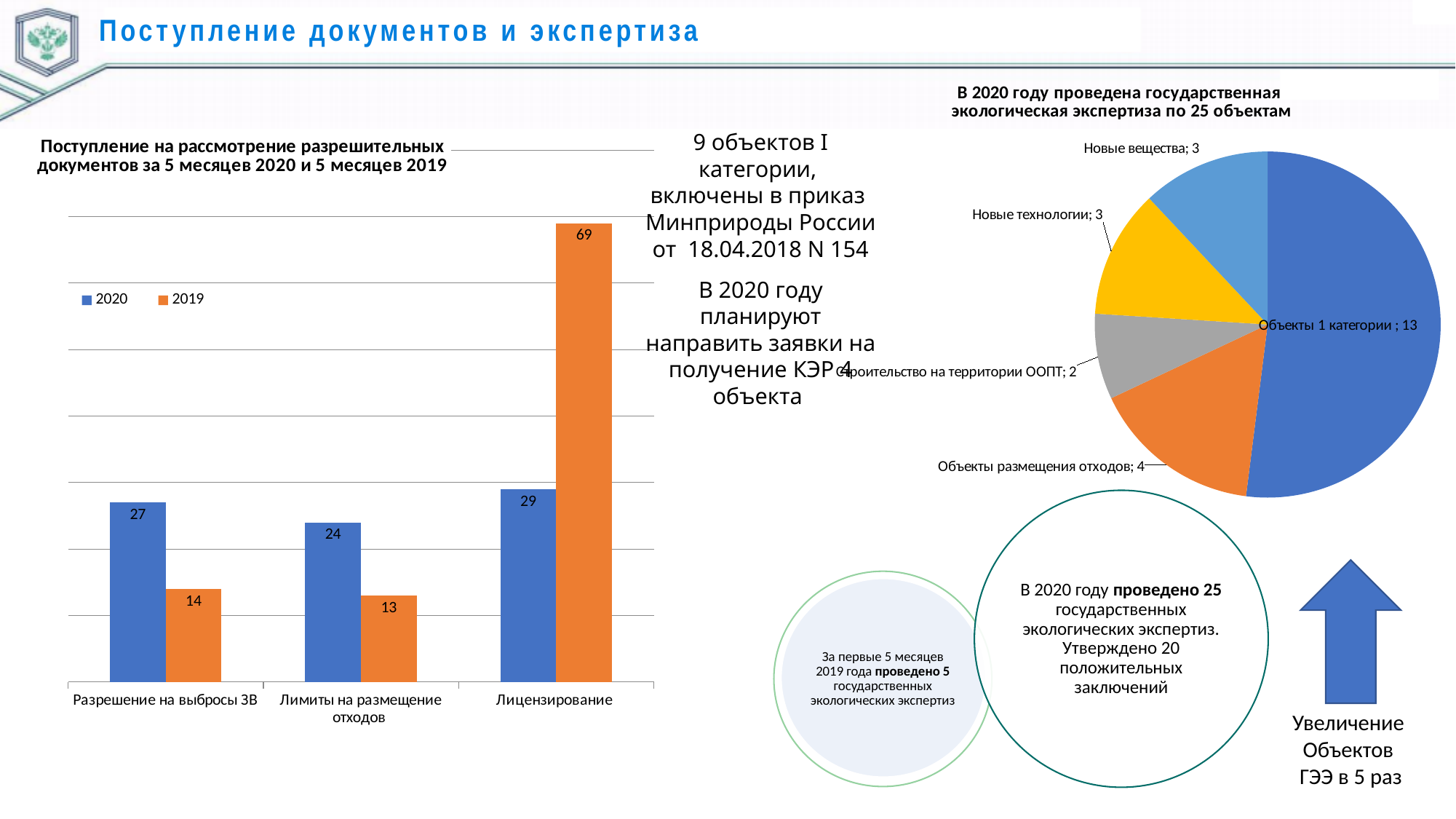
In the bar chart on the left, which category has the lowest 2020 value? Лимиты на размещение отходов How many slices does the pie chart on the right have? 5 In the bar chart on the left, what is the 2020 value for Лицензирование? 29 In the bar chart on the left, what is the difference between the 2019 and 2020 values for Лицензирование? 40 What kind of chart is the chart on the left of the slide? Bar chart In the pie chart on the right, what share of the total do Объекты размещения отходов represent? 16% How many categories are shown on the x axis of the bar chart on the left? 3 In the bar chart on the left, what is the 2019 value for Разрешение на выбросы ЗВ? 14 How many series does the legend of the bar chart on the left list? 2 In the bar chart on the left, which category has the highest 2019 value? Лицензирование In the pie chart on the right, what is the value for Объекты 1 категории? 13 In the bar chart on the left, which is larger for Лимиты на размещение отходов: the 2020 value or the 2019 value? 2020